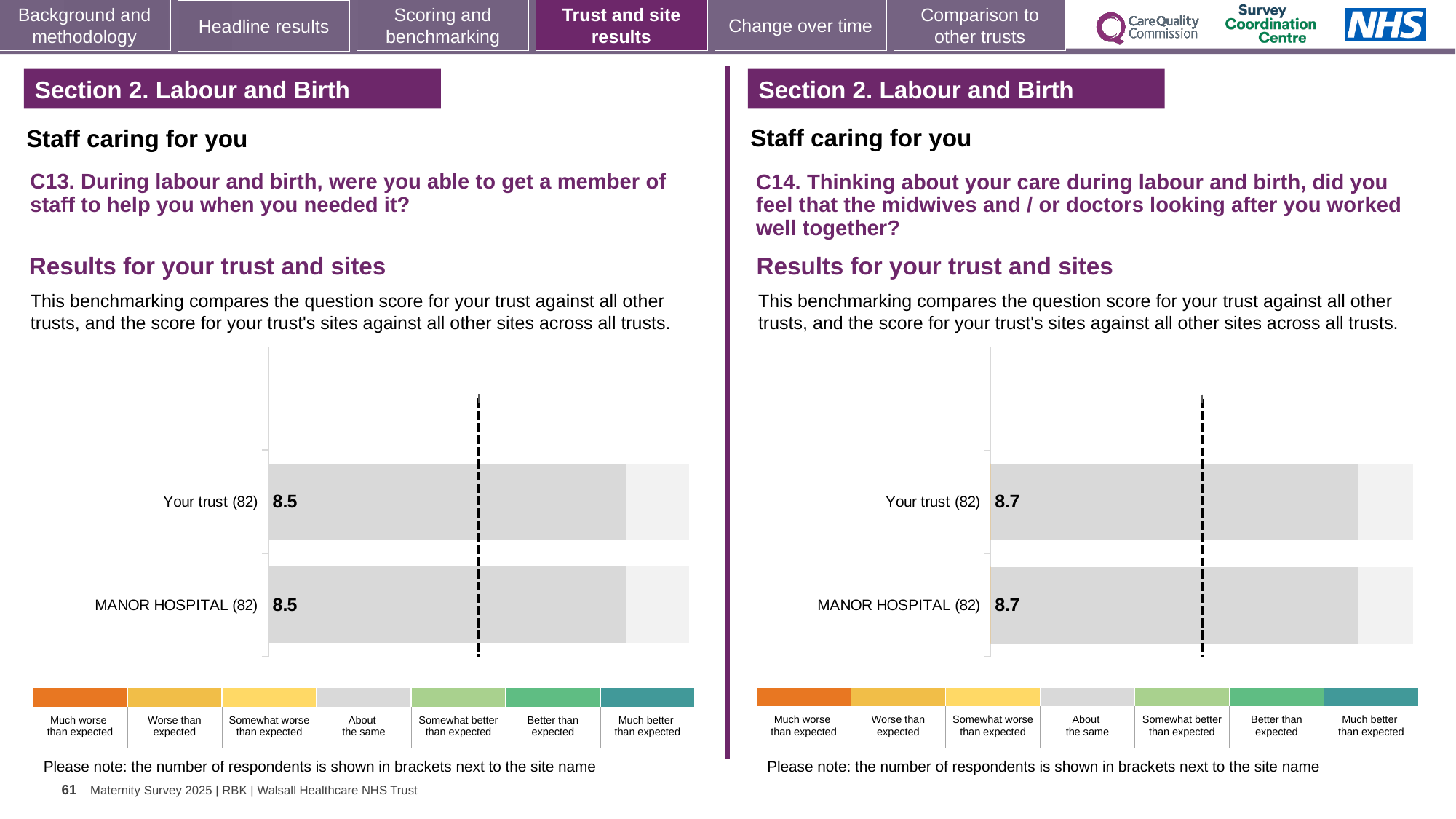
In the C13 chart on the left, how many bars are plotted? 2 What kind of chart is the C13 chart on the left? Bar chart In the C14 chart on the right, what is the score for MANOR HOSPITAL? 8.7 In the C14 chart on the right, how many bars are plotted? 2 In the colour key below the C13 chart on the left, what colour represents 'Much worse than expected'? Orange In the C13 chart on the left, what is the difference between the Your trust score and the MANOR HOSPITAL score? 0 In the C13 chart on the left, what is the score for Your trust? 8.5 In the C14 chart on the right, what is the difference between the Your trust score and the MANOR HOSPITAL score? 0 In the C14 chart on the right, what is the score for Your trust? 8.7 How many categories does the colour key below the C14 chart on the right list? 7 In the C13 chart on the left, what is the score for MANOR HOSPITAL? 8.5 In the C13 chart on the left, how many respondents are shown in brackets next to MANOR HOSPITAL? 82